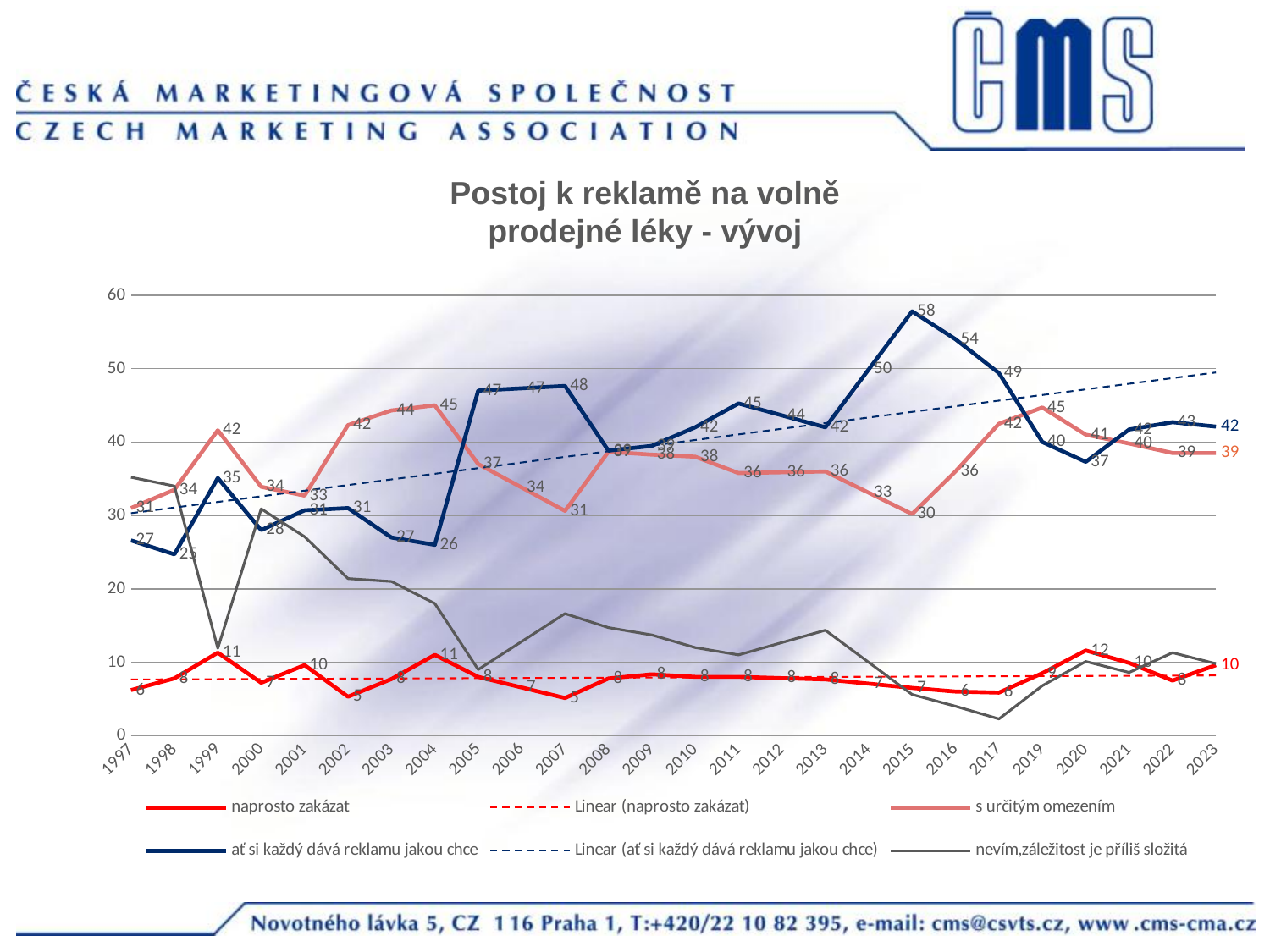
What is the value of the 'naprosto zakázat' series in 2023? 10 How many entries does the chart legend list? 6 In which year does the 'ať si každý dává reklamu jakou chce' series reach its highest value? 2015 In 2015, what is the difference between the 'ať si každý dává reklamu jakou chce' value and the 's určitým omezením' value? 28 In 2004, which series has the larger value: 's určitým omezením' or 'ať si každý dává reklamu jakou chce'? s určitým omezením Is the value of the 'nevím, záležitost je příliš složitá' series in 2017 greater or less than 10? less What is the value of the 's určitým omezením' series in 2023? 39 How many years are shown on the x axis of the chart? 26 What is the title of the chart? Postoj k reklamě na volně prodejné léky - vývoj What is the value of the 'ať si každý dává reklamu jakou chce' series in 2015? 58 What kind of chart is shown on the slide? line chart In which year does the 's určitým omezením' series reach its lowest value? 2015